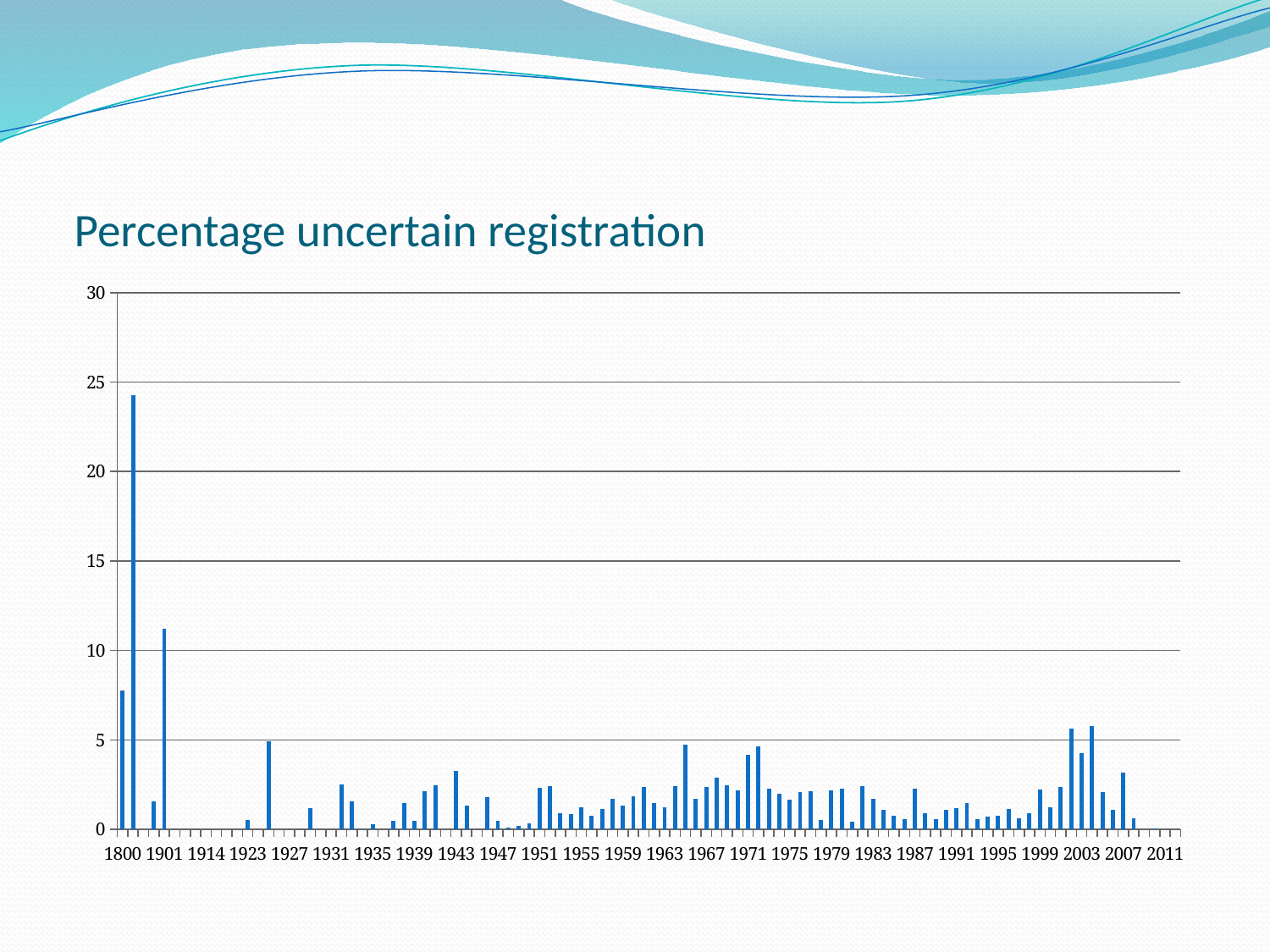
Is the tallest bar in the chart greater or less than 20? greater What is the title of the chart? Percentage uncertain registration Which has the larger value, 1901 or 2007? 1901 Is the value for 2007 greater or less than 5? less What is the highest value shown on the y axis? 30 What kind of chart is shown on the slide? bar chart Is the value for 1901 greater or less than 15? less Which has the larger value, 1800 or 1901? 1901